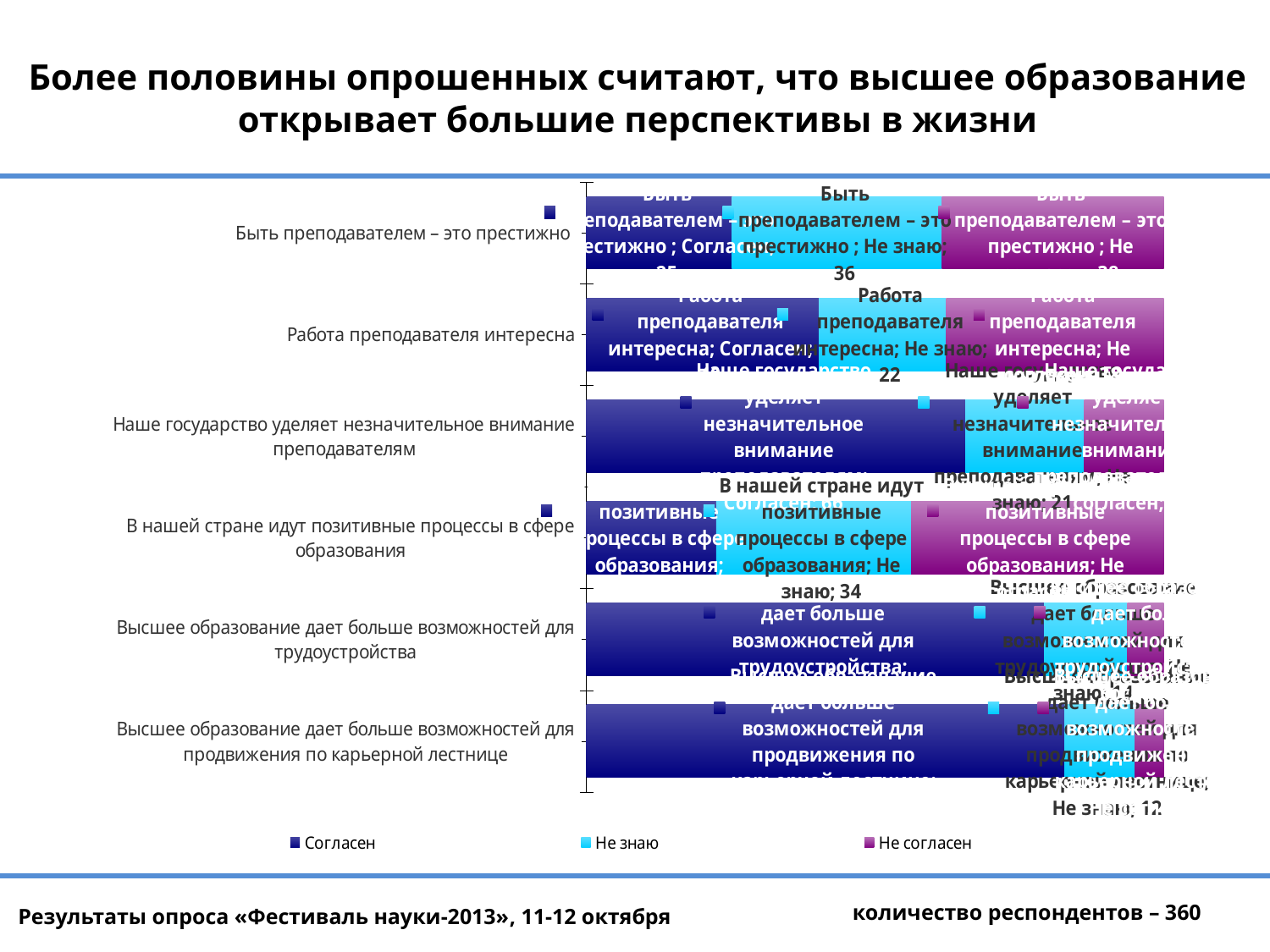
What are the three series named in the legend? Согласен, Не знаю, Не согласен How many categories (statements) are plotted on the chart? 6 What kind of chart is shown on the slide? Stacked bar chart What is the 'Не знаю' value for 'Работа преподавателя интересна'? 22 What is the difference between the 'Не знаю' values for 'Быть преподавателем – это престижно' and 'Работа преподавателя интересна'? 14 Which has the larger 'Не знаю' value: 'Быть преподавателем – это престижно' or 'Работа преподавателя интересна'? Быть преподавателем – это престижно Which statement has the largest 'Не согласен' segment? В нашей стране идут позитивные процессы в сфере образования What is the 'Не знаю' value for 'Быть преподавателем – это престижно'? 36 Which statement has the smallest 'Согласен' segment? В нашей стране идут позитивные процессы в сфере образования What is the 'Не знаю' value for 'В нашей стране идут позитивные процессы в сфере образования'? 34 Which statement has the larger 'Согласен' segment: 'Высшее образование дает больше возможностей для трудоустройства' or 'Быть преподавателем – это престижно'? Высшее образование дает больше возможностей для трудоустройства How many series does the legend list? 3